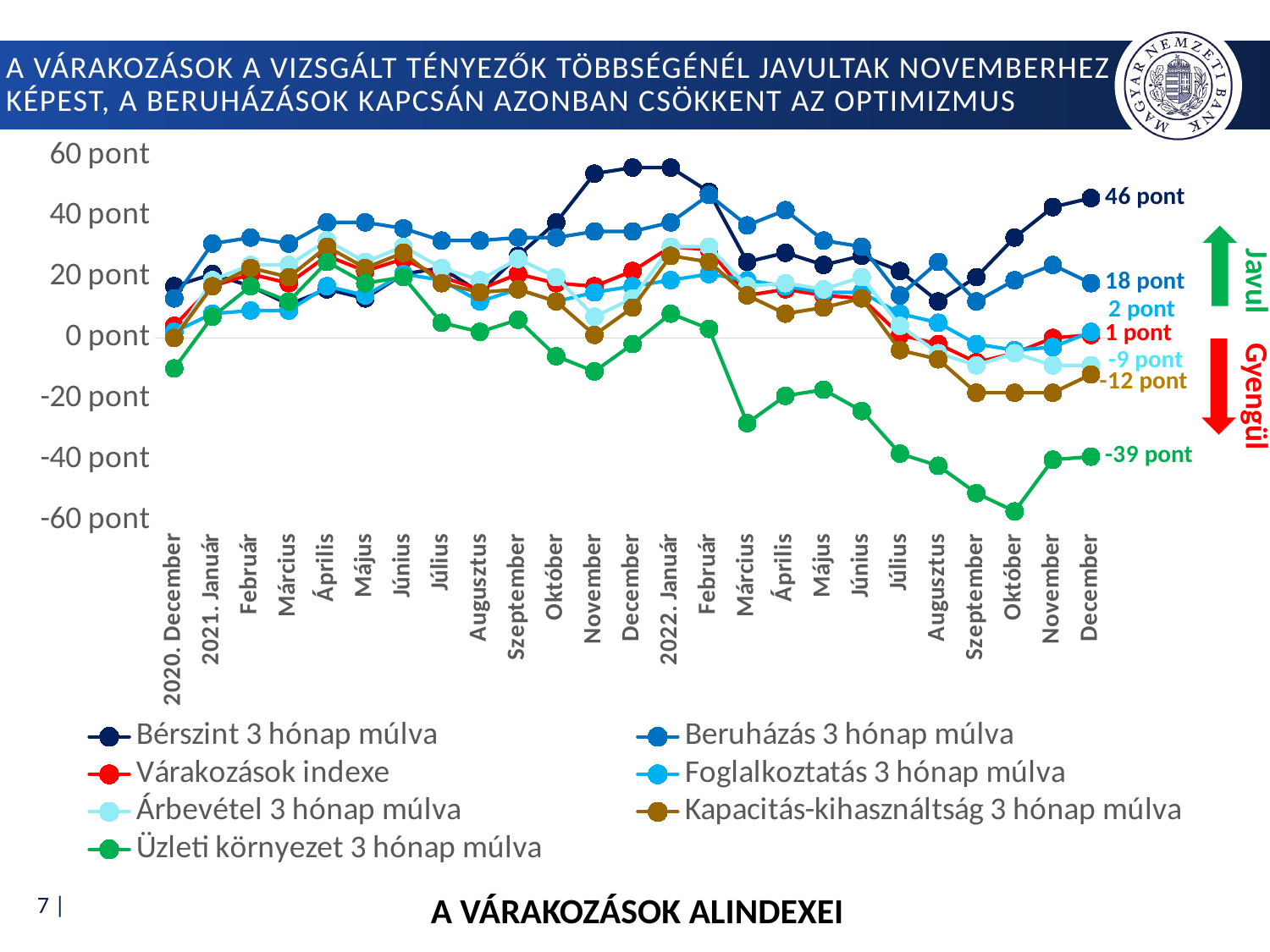
Which series has the lowest value in December 2022? Üzleti környezet 3 hónap múlva What is the value of 'Bérszint 3 hónap múlva' in December 2022? 46 pont What is the value of 'Üzleti környezet 3 hónap múlva' in December 2022? -39 pont How many series does the legend list? 7 Which series has the highest value in December 2022? Bérszint 3 hónap múlva What type of chart is shown on the slide? line chart What is the difference between 'Bérszint 3 hónap múlva' and 'Beruházás 3 hónap múlva' in December 2022? 28 pont What is the value of 'Beruházás 3 hónap múlva' in December 2022? 18 pont What is the value of 'Kapacitás-kihasználtság 3 hónap múlva' in December 2022? -12 pont How many months are shown on the x axis? 25 In December 2022, which is larger: 'Árbevétel 3 hónap múlva' or 'Kapacitás-kihasználtság 3 hónap múlva'? Árbevétel 3 hónap múlva Is the value of 'Bérszint 3 hónap múlva' in November 2021 greater or less than 40 pont? greater